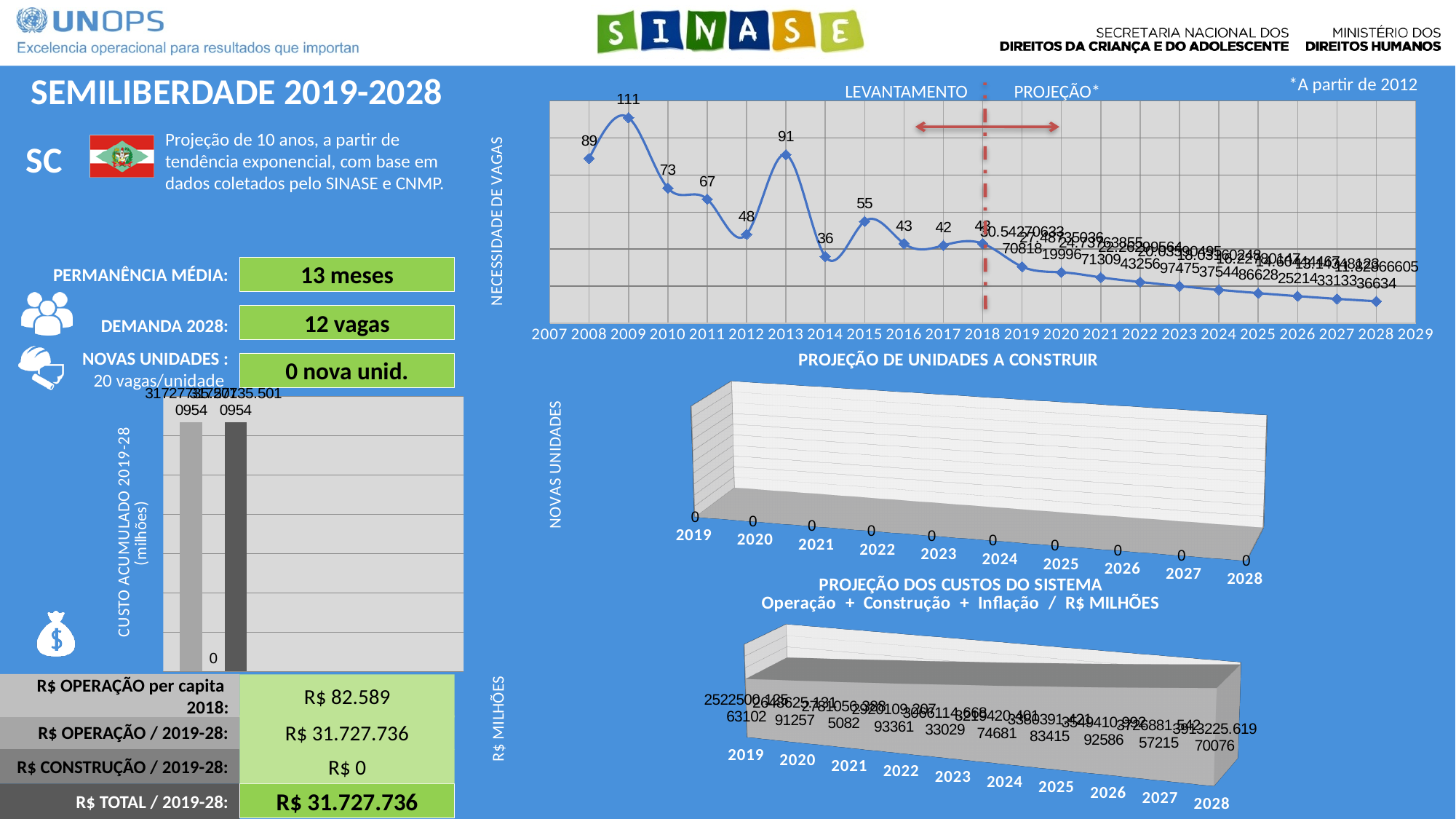
How many years are shown on the x axis of the chart titled PROJEÇÃO DE UNIDADES A CONSTRUIR? 10 In the top-right line chart (NECESSIDADE DE VAGAS), which year has the highest value? 2009 In the top-right line chart (NECESSIDADE DE VAGAS), what is the difference between the 2013 value and the 2014 value? 55 In the top-right line chart (NECESSIDADE DE VAGAS), what is the value for 2014? 36 In the top-right line chart (NECESSIDADE DE VAGAS), what is the value for 2009? 111 In the chart titled PROJEÇÃO DE UNIDADES A CONSTRUIR, what is the value for 2019? 0 In the top-right line chart (NECESSIDADE DE VAGAS), which is larger, the value for 2010 or the value for 2011? 2010 What kind of chart is the top-right chart labelled NECESSIDADE DE VAGAS? line chart What is the y-axis label of the top-right line chart? NECESSIDADE DE VAGAS In the top-right line chart (NECESSIDADE DE VAGAS), what is the value for 2013? 91 In the top-right line chart (NECESSIDADE DE VAGAS), do the values rise or fall from 2018 to 2028? fall In the top-right line chart (NECESSIDADE DE VAGAS), what is the difference between the 2009 value and the 2008 value? 22